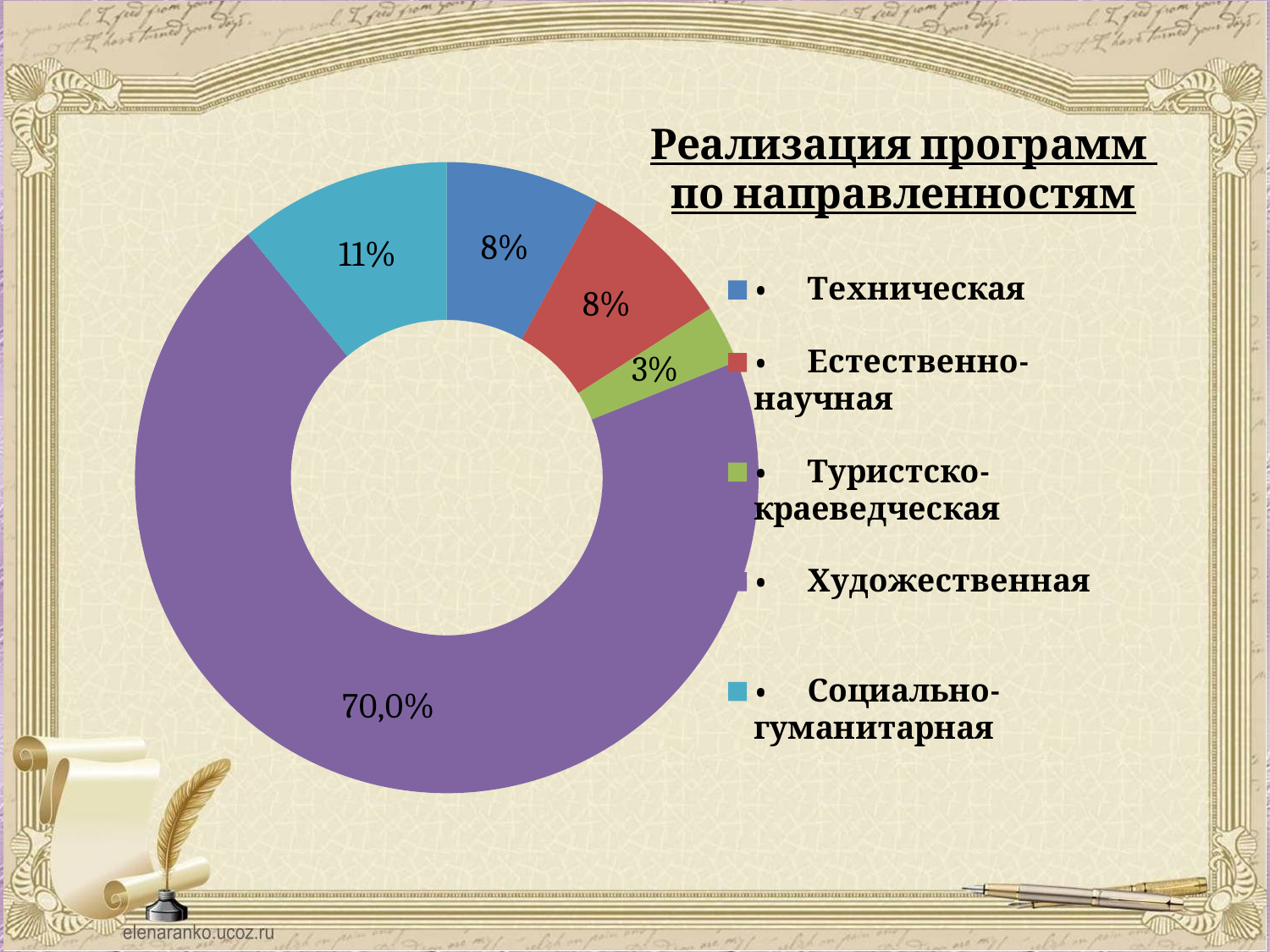
What is the value shown for Социально-гуманитарная? 11% What is the value shown for Естественно-научная? 8% What is the value shown for Туристско-краеведческая? 3% What share of the chart does Художественная take? 70,0% What is the value shown for Техническая? 8% What is the difference between the share for Социально-гуманитарная and the share for Туристско-краеведческая? 8% Which category has the smallest share of the chart? Туристско-краеведческая What is the title of the chart? Реализация программ по направленностям Which is larger, the share for Социально-гуманитарная or the share for Техническая? Социально-гуманитарная Which category has the largest share of the chart? Художественная What kind of chart is shown on the slide? doughnut chart How many categories does the legend list? 5